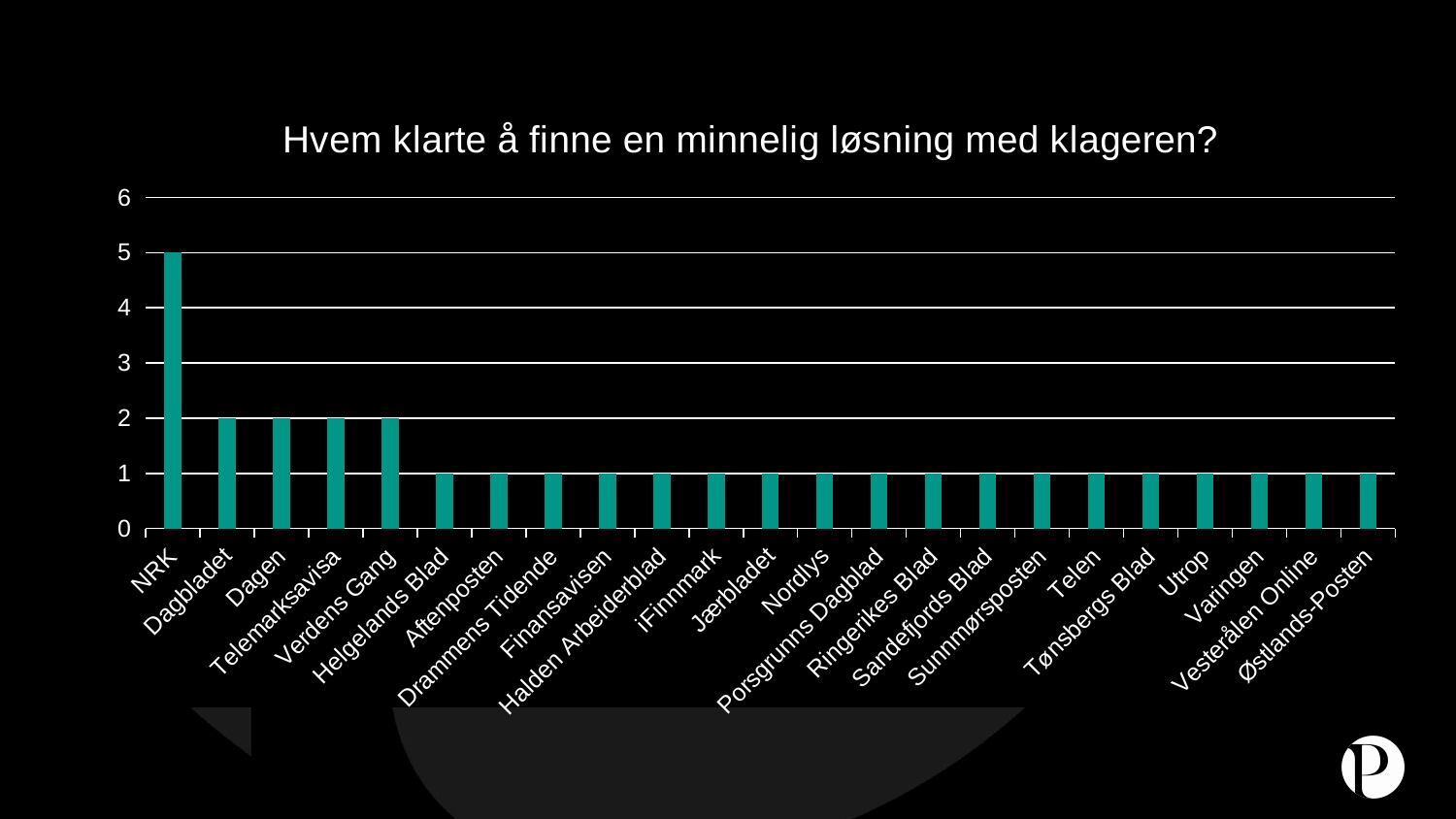
What is the value for Aftenposten? 1 What is the value for NRK? 5 Which is larger, the value for Dagen or the value for Nordlys? Dagen Is the value for NRK greater or less than 4? greater Which category has the highest value? NRK What is the value for Dagbladet? 2 What is the difference between the values for NRK and Telemarksavisa? 3 What kind of chart is shown on the slide? bar chart How many categories are shown on the x axis? 23 What is the title of the chart? Hvem klarte å finne en minnelig løsning med klageren? What is the highest value shown on the y axis? 6 What is the value for Verdens Gang? 2